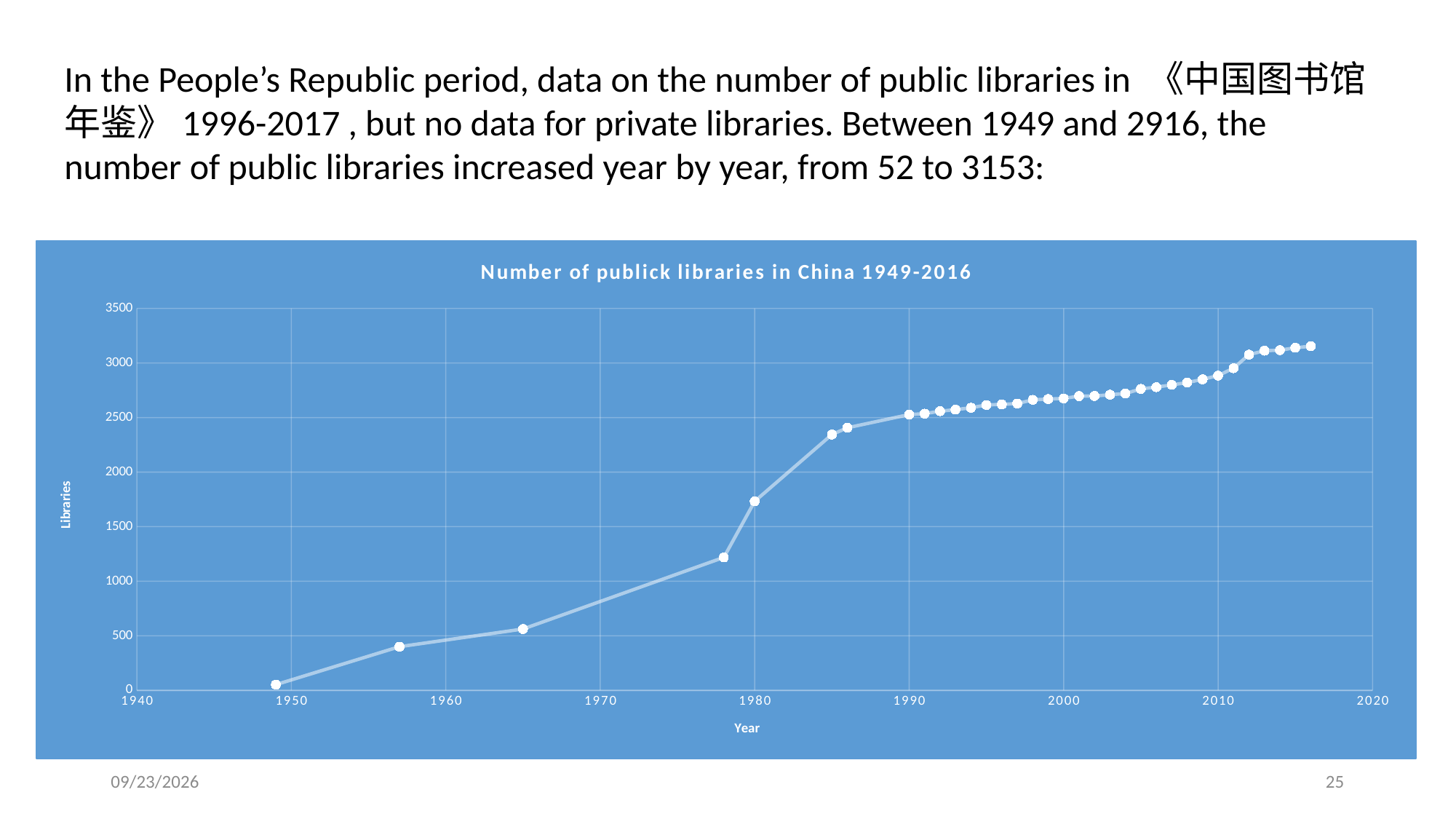
Which year has the highest number of libraries? 2016 What kind of chart is shown on the slide? line chart Is the value for 1978 greater or less than 1000? greater Is the value for 2016 greater or less than 3000? greater What is the title of the chart? Number of publick libraries in China 1949-2016 Which is larger, the value for 1978 or the value for 1980? 1980 Which year has the lowest number of libraries? 1949 Is the value for 1985 greater or less than 2500? less What is the label of the vertical axis? Libraries Do the values rise or fall as the years increase along the x axis? rise